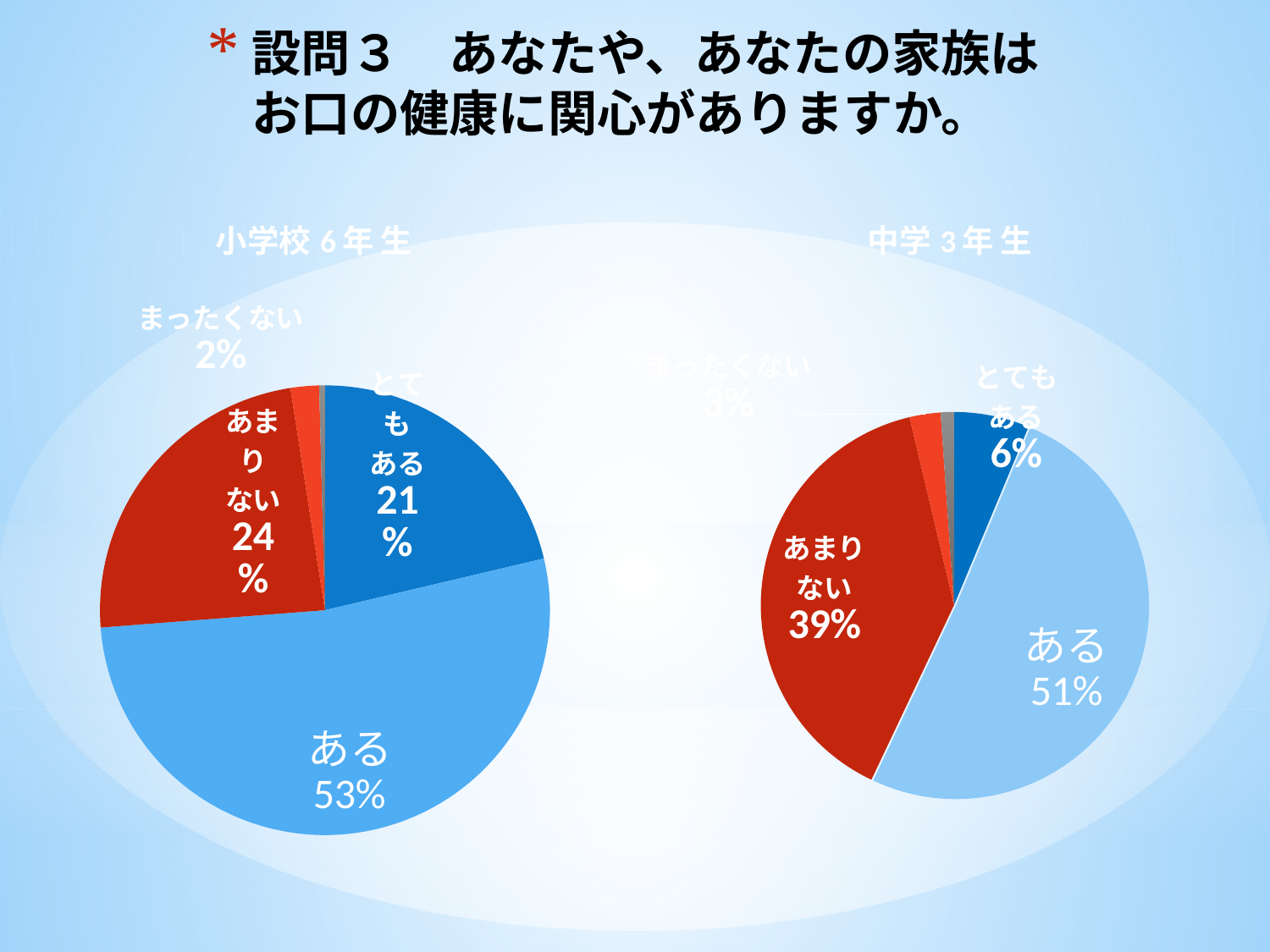
In the 中学３年生 pie chart, what percentage is shown for あまりない? 39% In the 小学校６年生 pie chart, what percentage is shown for あまりない? 24% In the 小学校６年生 pie chart, what percentage is shown for ある? 53% Which is larger: the とてもある share in the 小学校６年生 chart or the とてもある share in the 中学３年生 chart? 小学校６年生 What is the title of the chart on the left? 小学校６年生 In the 中学３年生 pie chart, what is the combined share of とてもある and ある? 57% In the 小学校６年生 pie chart, what is the difference between the shares for ある and あまりない? 29% How many slices does the 中学３年生 pie chart have? 5 In the 中学３年生 pie chart, what percentage is shown for とてもある? 6% In the 小学校６年生 pie chart, which category has the largest share? ある What type of chart is used on this slide? Pie chart